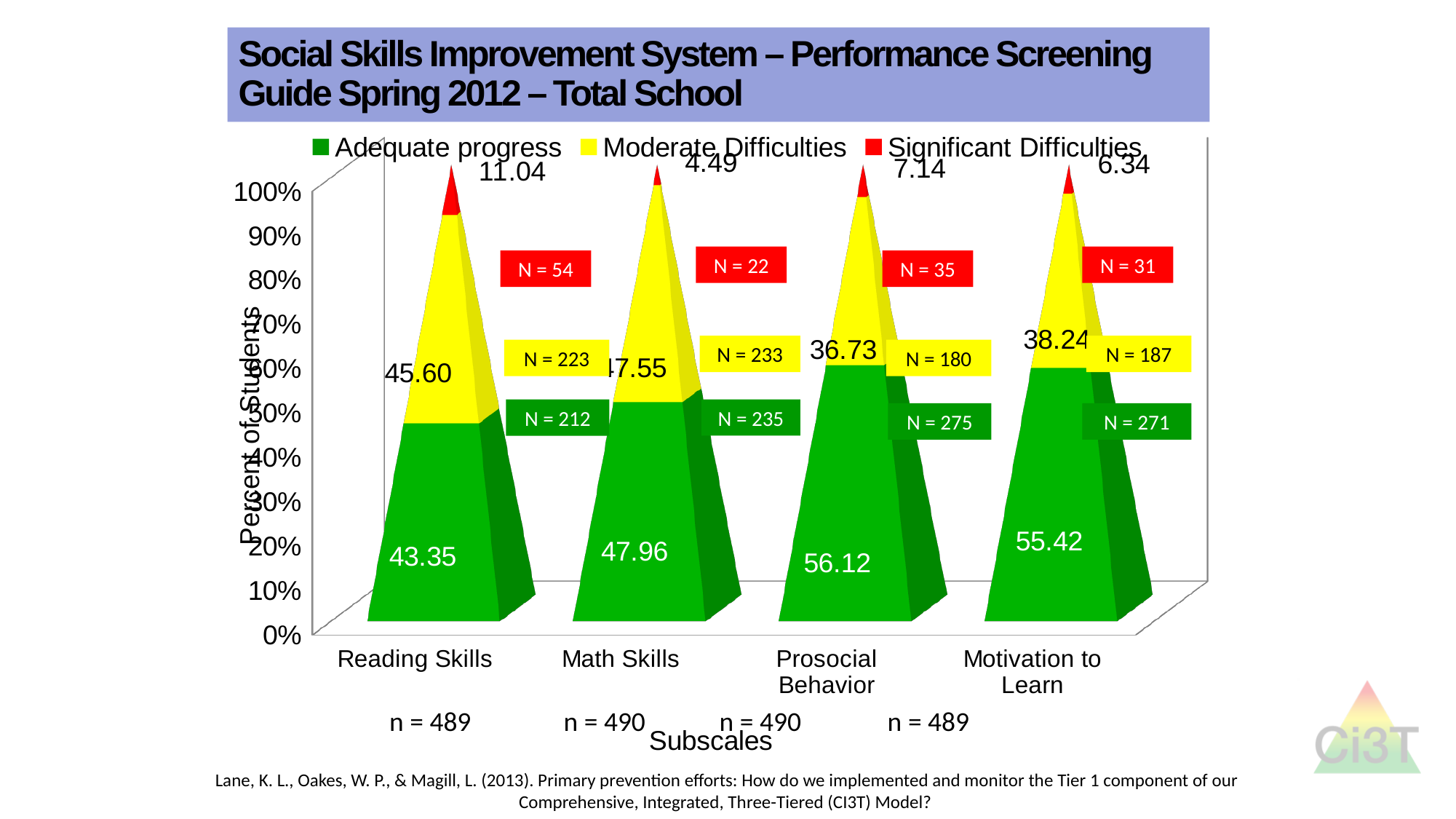
What is the Significant Difficulties value for Motivation to Learn? 6.34 Which subscale has the lowest Significant Difficulties value? Math Skills How many series does the legend list? 3 What is the Significant Difficulties value for Math Skills? 4.49 What kind of chart is shown on the slide? Stacked bar chart Which subscale has the highest Adequate progress value? Prosocial Behavior What is the Moderate Difficulties value for Prosocial Behavior? 36.73 How many subscales are shown on the x axis? 4 What is the difference between the Adequate progress values for Prosocial Behavior and Reading Skills? 12.77 What is the Adequate progress value for Reading Skills? 43.35 What is the N count shown for Adequate progress in Math Skills? N = 235 Which has a larger Significant Difficulties value, Reading Skills or Motivation to Learn? Reading Skills